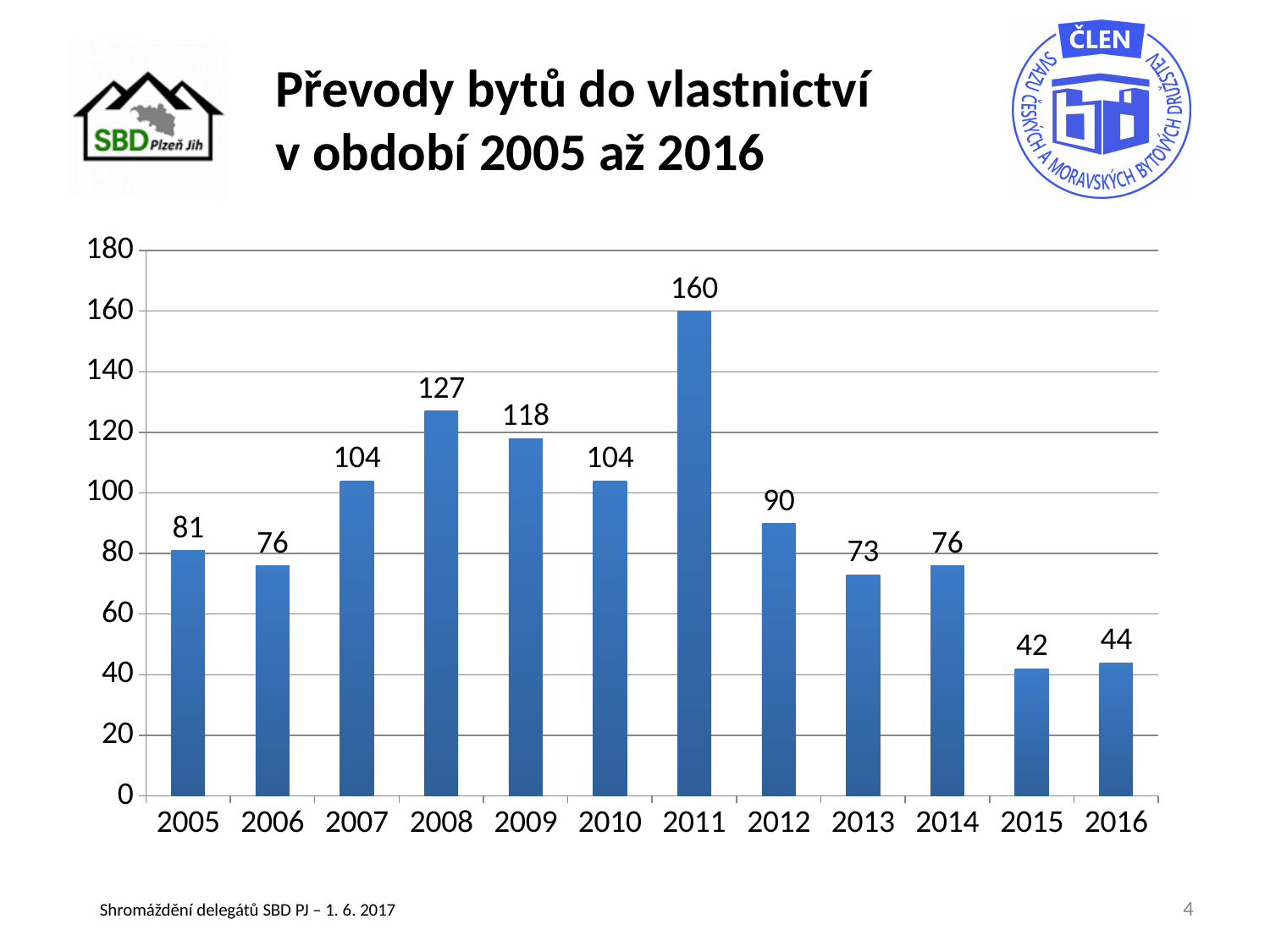
Which year has the lowest value? 2015 Do the values rise or fall from 2011 to 2015? fall What is the value for 2008? 127 What is the value for 2015? 42 How many years are shown on the x axis? 12 Which is larger, the value for 2009 or the value for 2010? 2009 What kind of chart is shown on the slide? bar chart What is the difference between the values for 2016 and 2015? 2 Is the value for 2013 greater or less than 80? less What is the value for 2011? 160 Which year has the highest value? 2011 What is the difference between the values for 2011 and 2012? 70